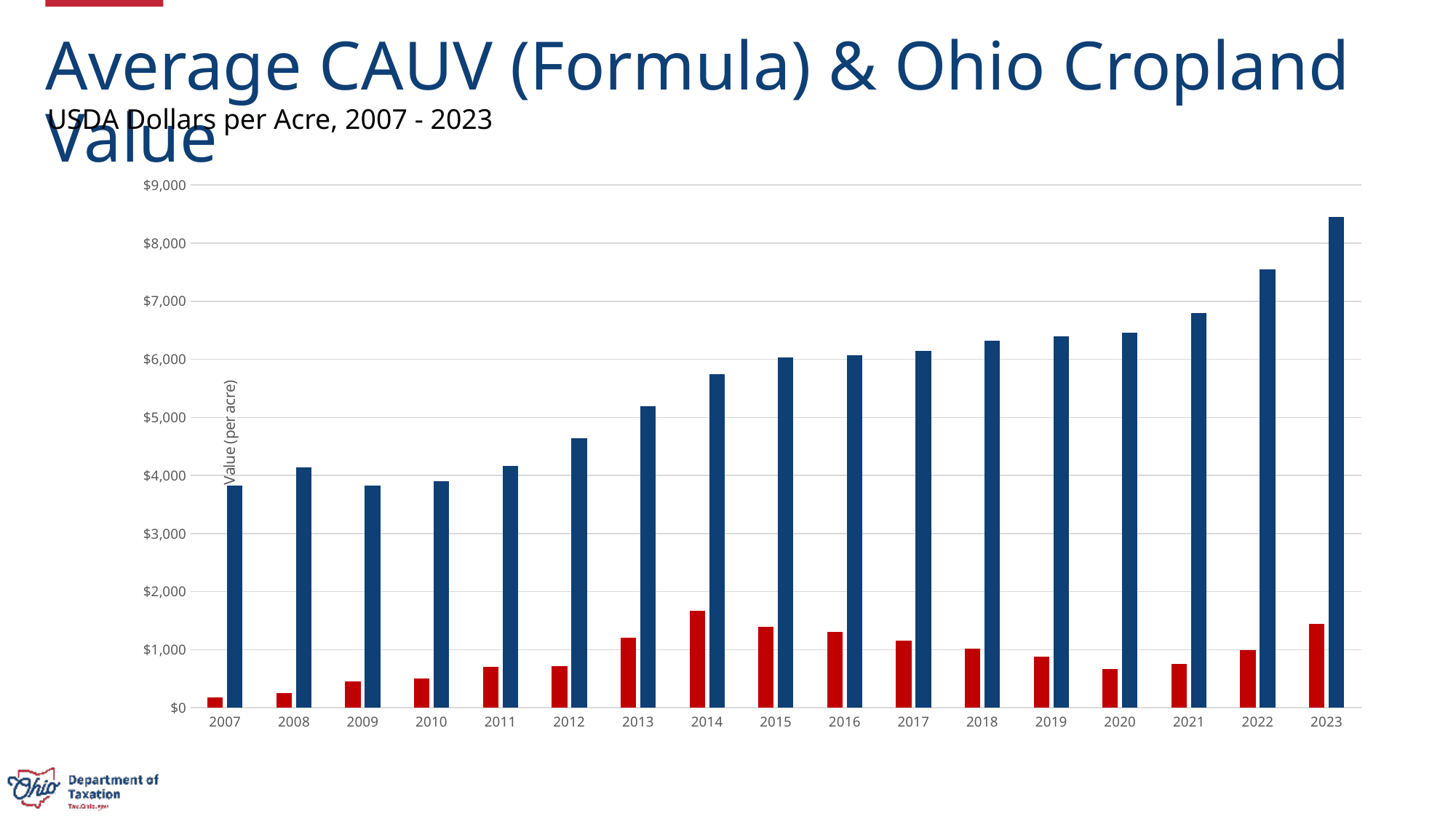
Which year has the larger blue bar, 2021 or 2022? 2022 Is the value of the blue bar for 2012 greater or less than $5,000? less Is the value of the blue bar for 2023 greater or less than $8,000? greater What kind of chart is shown on the slide? Bar chart Is the value of the red bar for 2014 greater or less than $1,500? greater How many years are shown on the x axis of the chart? 17 In which year is the blue bar the tallest? 2023 Do the blue bars generally rise or fall from 2012 to 2023? Rise What is the label on the vertical axis of the chart? Value (per acre) In which year is the red bar the shortest? 2007 In which year is the red bar the tallest? 2014